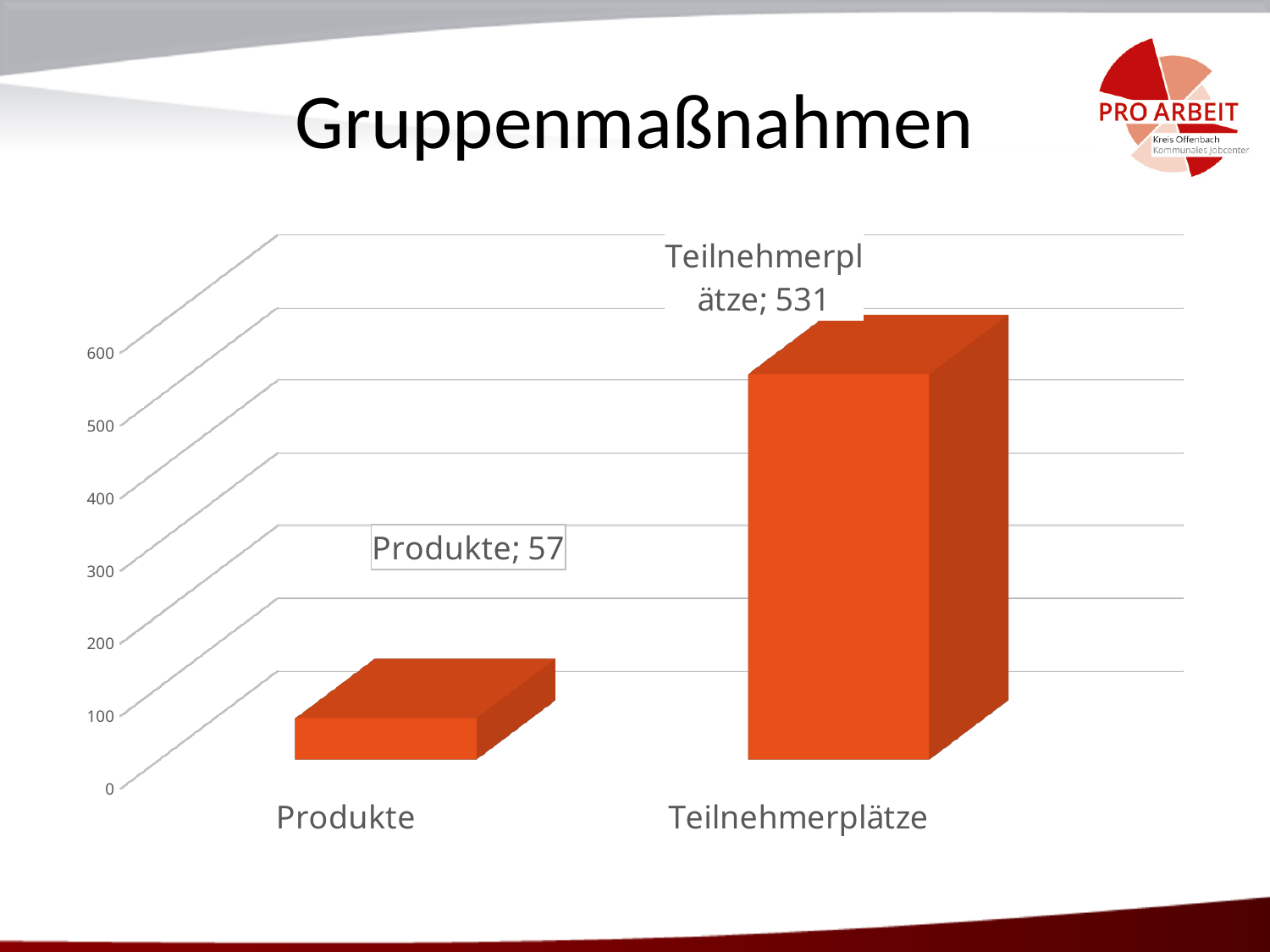
What is the difference between the values for Teilnehmerplätze and Produkte? 474 Is the value for Produkte greater or less than 100? less How many categories are shown on the chart? 2 Which category has the lowest value? Produkte What is the highest value shown on the vertical axis? 600 What is the value for Teilnehmerplätze? 531 Is the value for Teilnehmerplätze greater or less than 500? greater What is the title of the slide containing the chart? Gruppenmaßnahmen What kind of chart is shown on the slide? bar chart Which category has the highest value? Teilnehmerplätze What is the value for Produkte? 57 Which is larger, the value for Produkte or the value for Teilnehmerplätze? Teilnehmerplätze